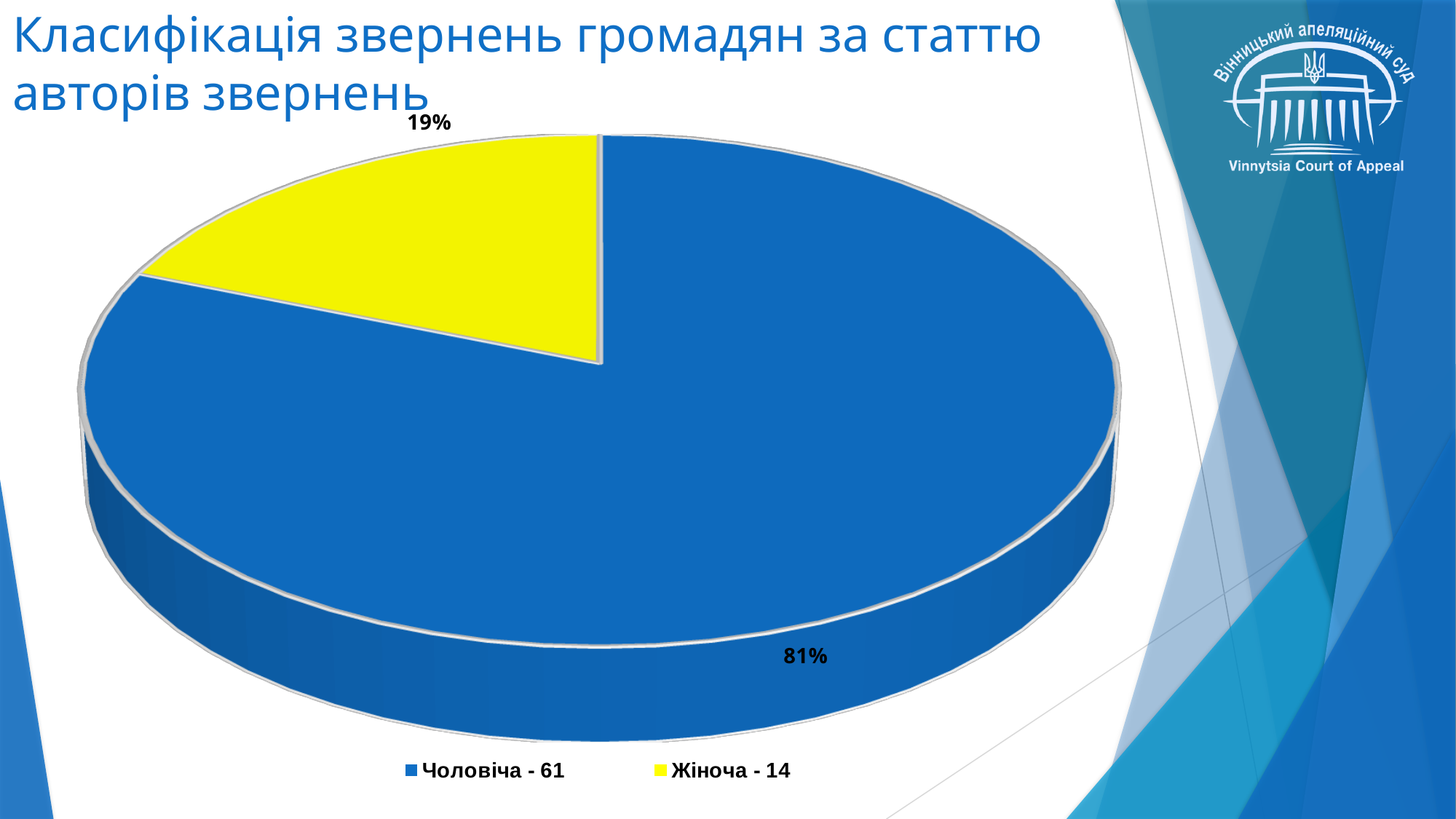
What percentage share does the Чоловіча slice have? 81% Which category has the largest slice of the pie? Чоловіча What is the difference in percentage points between the Чоловіча and Жіноча slices? 62 percentage points How many entries does the legend list? 2 Which slice is larger, Чоловіча or Жіноча? Чоловіча What colour is the Жіноча slice? yellow Which category has the smallest slice of the pie? Жіноча What count is shown in the legend for Чоловіча? 61 What percentage share does the Жіноча slice have? 19% What count is shown in the legend for Жіноча? 14 What kind of chart is shown on the slide? pie chart How many slices does the pie chart have? 2